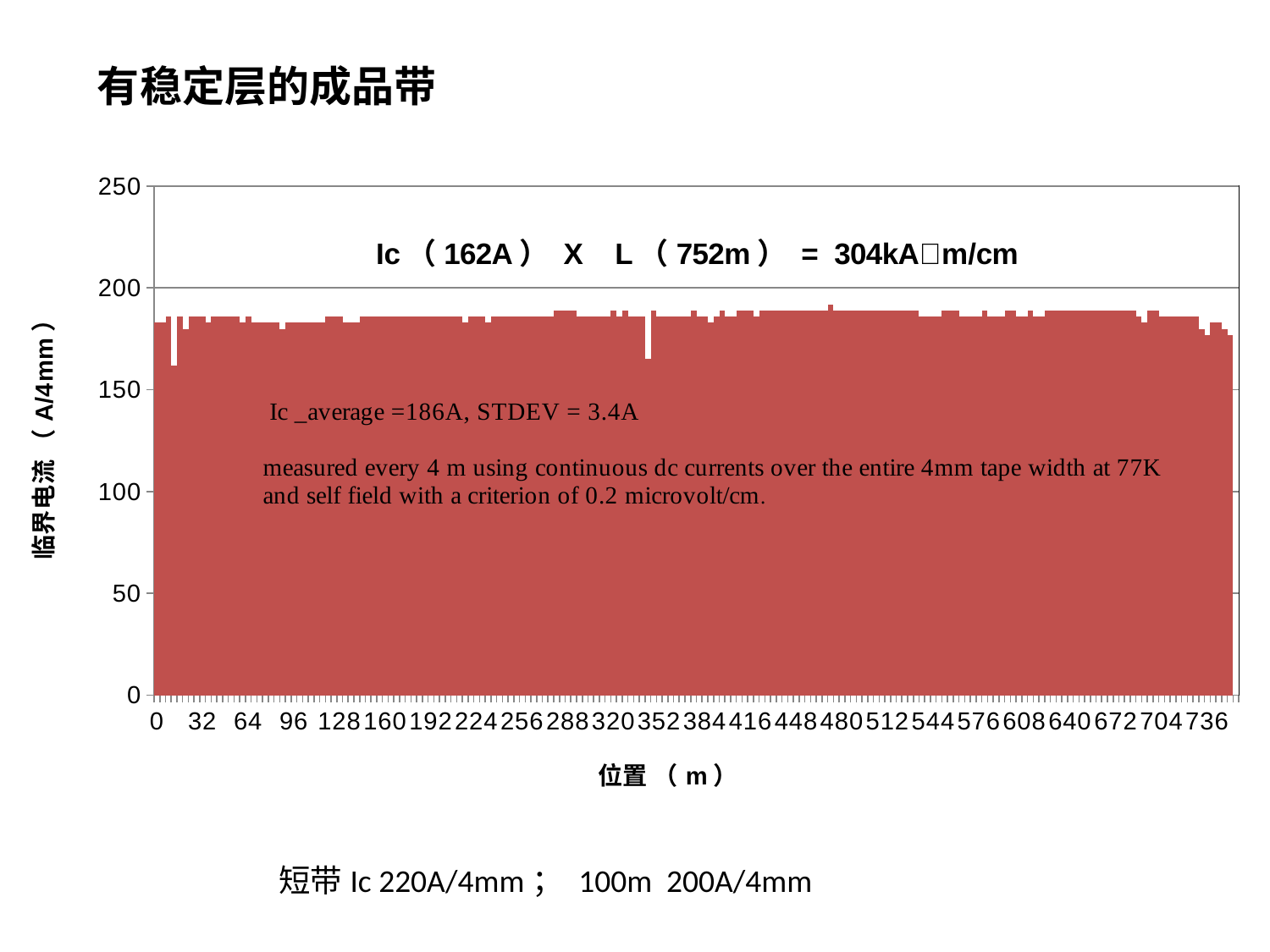
What is the label of the y axis? 临界电流（A/4mm） According to the annotation on the chart, what is the average Ic? 186A What is the highest value shown on the y axis? 250 Do the values rise, fall, or stay roughly flat along the x axis? stay roughly flat According to the annotation on the chart, what is the STDEV of Ic? 3.4A According to the annotation on the chart, what is the tape length L? 752m Is the value for position 384 m greater or less than 200? less What is the label of the x axis? 位置（m） Is the value for position 736 m greater or less than 100? greater Is the value for position 0 m greater or less than 150? greater What kind of chart is shown on the slide? bar chart